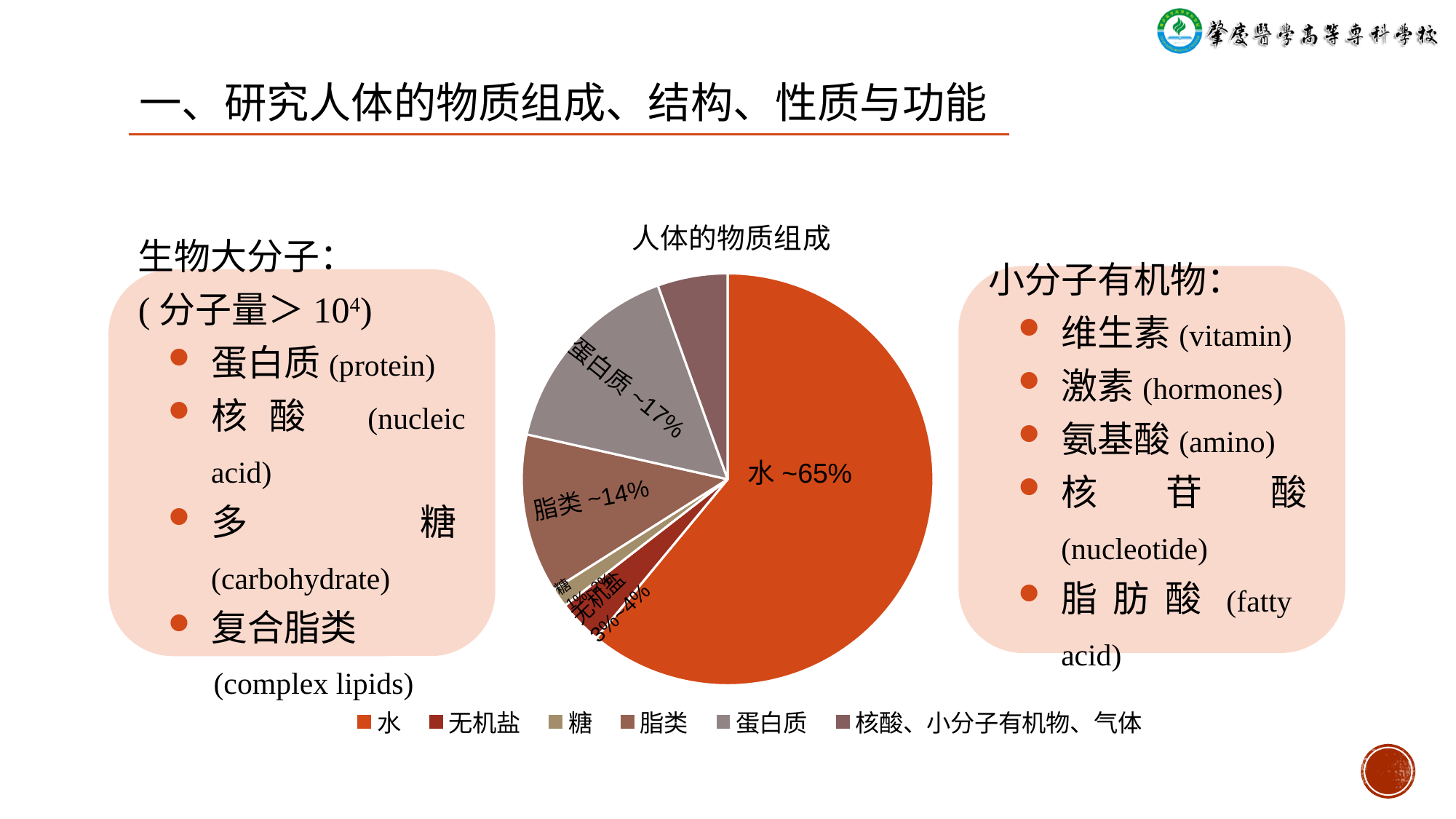
What type of chart is shown on the slide? pie chart How many entries does the legend of the pie chart list? 6 What is the title of the pie chart? 人体的物质组成 What value is printed on the 无机盐 slice of the pie chart? 3%~4% Which category has the largest slice in the pie chart? 水 Which slice is larger, 水 or 蛋白质? 水 What value is printed on the 蛋白质 slice of the pie chart? ~17% What value is printed on the 水 slice of the pie chart? ~65% Which legend entry is listed last in the pie chart's legend? 核酸、小分子有机物、气体 Which slice is larger, 脂类 or 无机盐? 脂类 How many slices does the pie chart have? 6 What value is printed on the 脂类 slice of the pie chart? ~14%